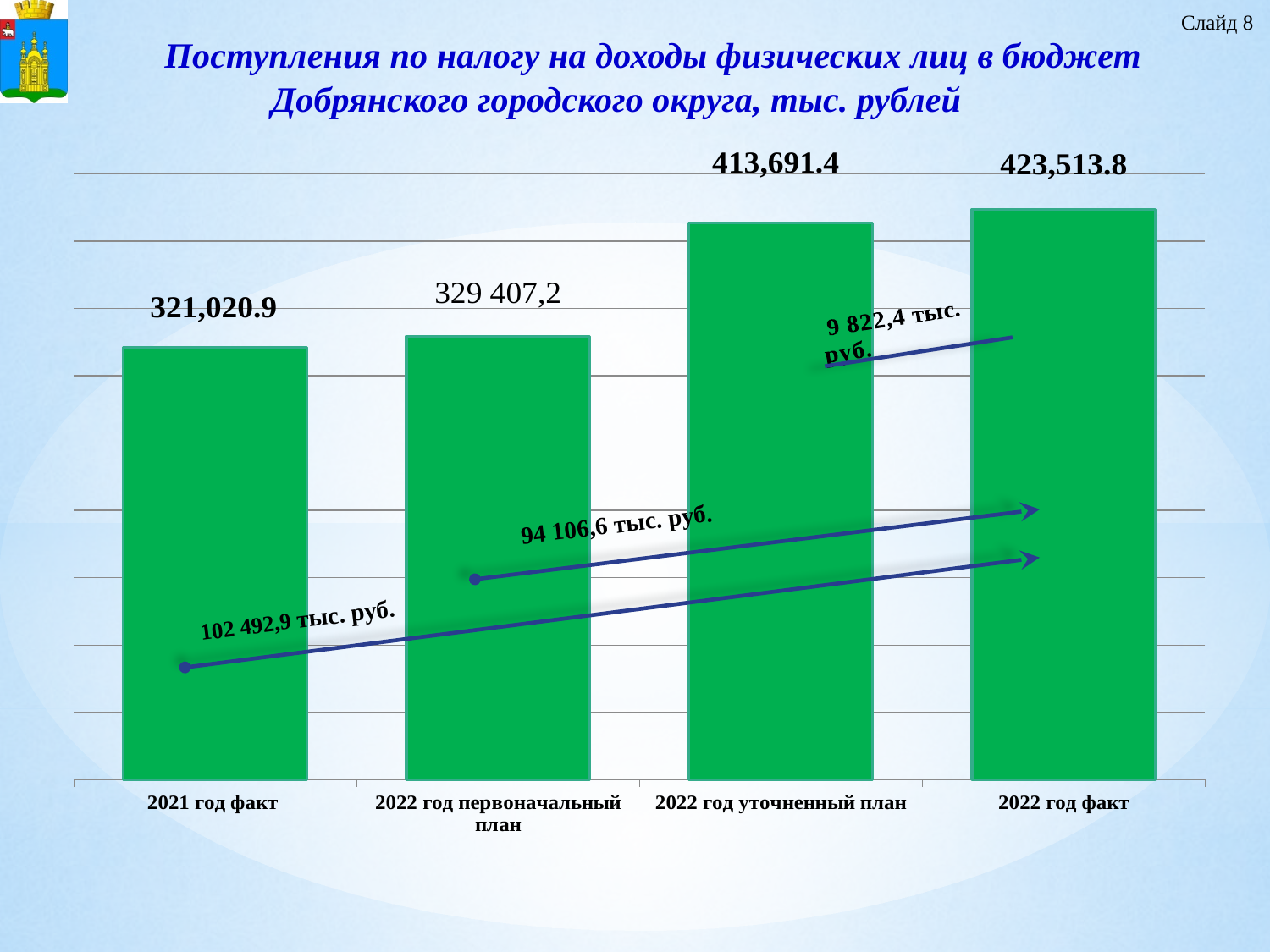
Which is larger: 2022 год первоначальный план or 2022 год уточненный план? 2022 год уточненный план What is the value for 2022 год уточненный план? 413,691.4 What is the value for 2021 год факт? 321,020.9 Do the values rise or fall from left to right across the categories? Rise Which category has the lowest value? 2021 год факт What kind of chart is shown on the slide? Bar chart What is the difference between 2022 год факт and 2022 год уточненный план? 9 822,4 тыс. руб. Which category has the highest value? 2022 год факт What is the value for 2022 год факт? 423,513.8 How many bars are shown in the chart? 4 What is the value for 2022 год первоначальный план? 329 407,2 What is the difference between 2022 год факт and 2021 год факт? 102 492,9 тыс. руб.